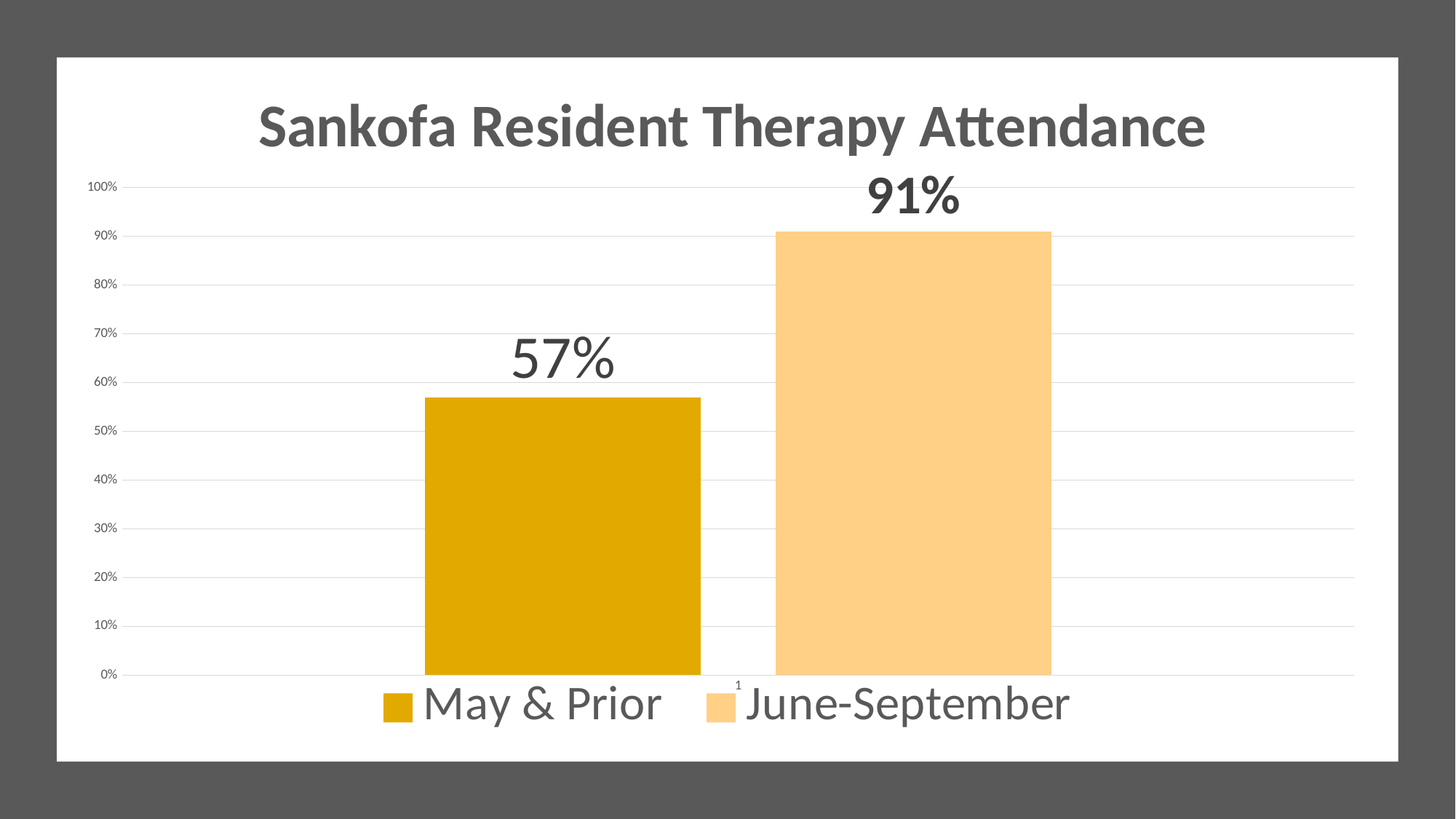
What is the highest value shown on the vertical axis? 100% How many series does the legend list? 2 What is the difference in attendance between June-September and May & Prior? 34% What is the therapy attendance value for June-September? 91% Is the attendance for June-September greater or less than 90%? greater Which period has the lower therapy attendance? May & Prior Is the attendance for May & Prior greater or less than 60%? less How many bars are plotted in the chart? 2 What is the therapy attendance value for May & Prior? 57% What is the title of the chart? Sankofa Resident Therapy Attendance What kind of chart is shown on the slide? Bar chart Which period has the higher therapy attendance? June-September